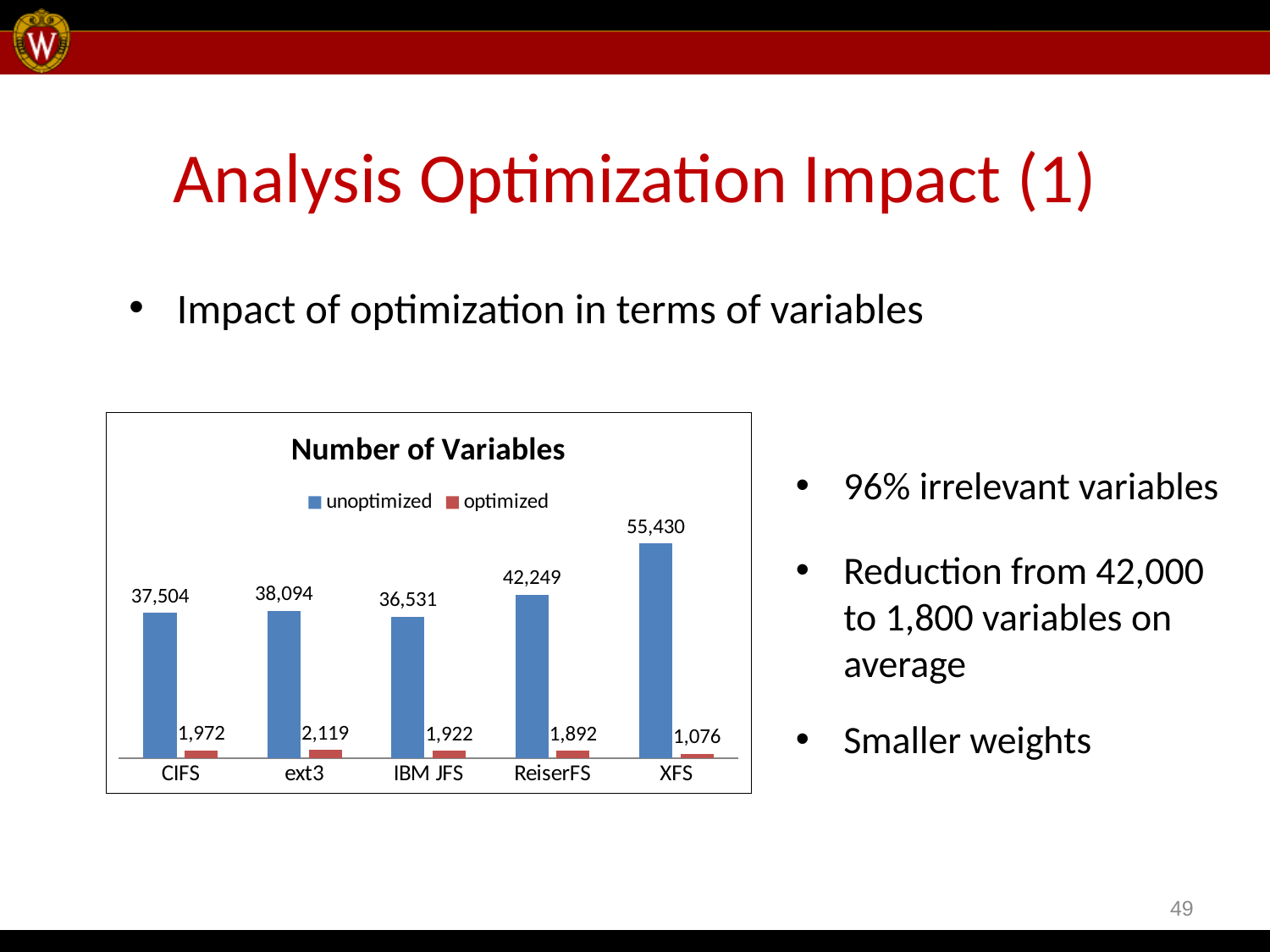
What is the optimized number of variables for ext3? 2,119 Which is larger, the optimized value for IBM JFS or the optimized value for ReiserFS? IBM JFS Which file system has the lowest optimized number of variables? XFS What is the title of the chart? Number of Variables What is the difference between the unoptimized and optimized number of variables for CIFS? 35,532 Which file system has the lowest unoptimized number of variables? IBM JFS Which file system has the highest unoptimized number of variables? XFS How many series does the legend list? 2 How many file systems are shown on the x axis? 5 What kind of chart is shown? Bar chart What is the unoptimized number of variables for ReiserFS? 42,249 What is the unoptimized number of variables for XFS? 55,430